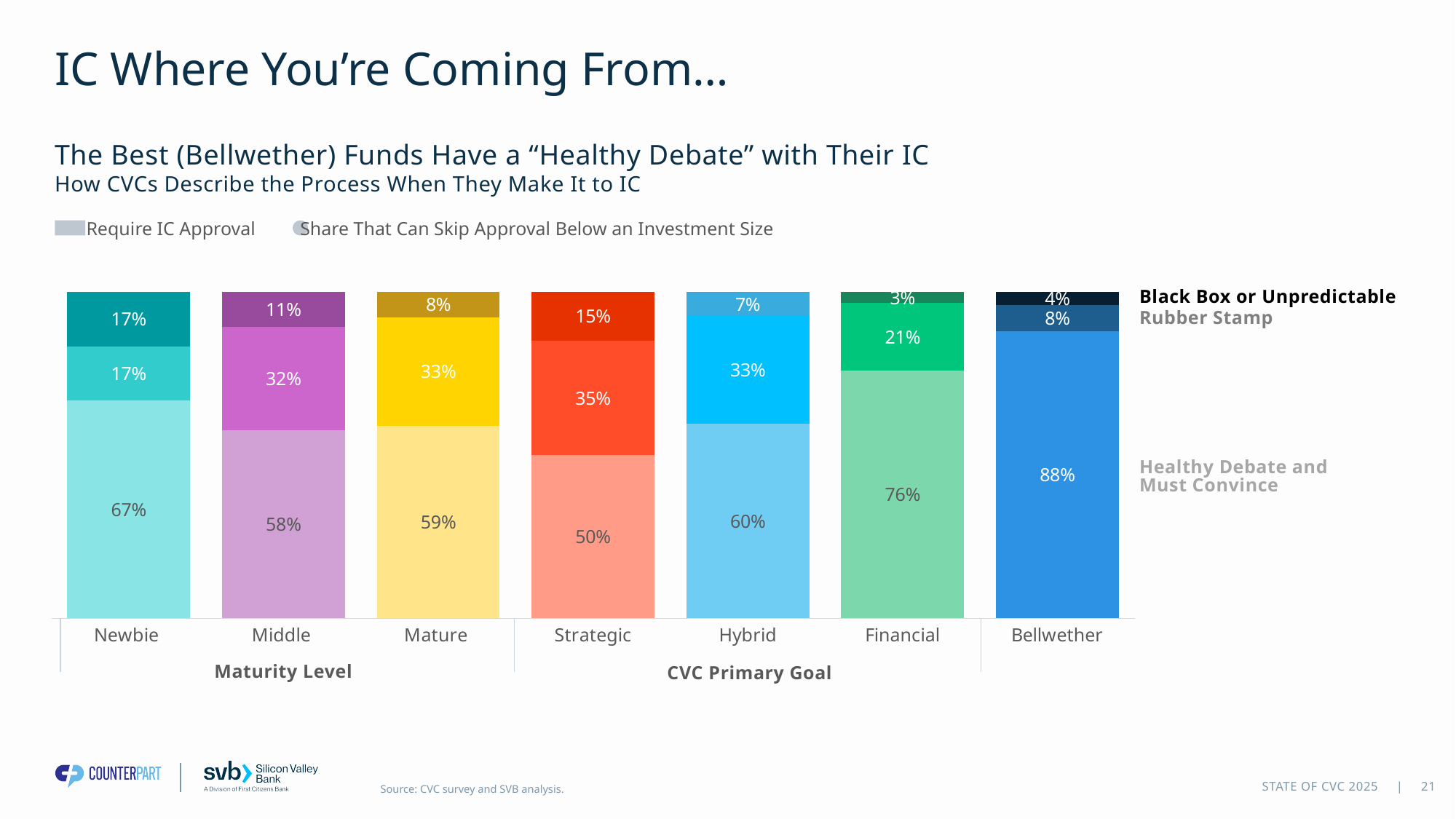
Which category has the highest Healthy Debate and Must Convince share? Bellwether Which category has the lowest Black Box or Unpredictable share? Financial What type of chart is used on this slide? Stacked bar chart Which category has the lowest Healthy Debate and Must Convince share? Strategic What is the Black Box or Unpredictable share for Newbie CVCs? 17% How many categories are shown along the x axis of the chart? 7 Which is larger, the Rubber Stamp share for Middle or for Mature CVCs? Mature Which two group headings are shown beneath the x-axis categories? Maturity Level and CVC Primary Goal What is the Rubber Stamp share for Strategic CVCs? 35% What is the total of the Hybrid bar's three segments? 100% What is the difference between the Healthy Debate and Must Convince shares for Financial and Strategic CVCs? 26% What percentage of Bellwether funds describe the IC process as Healthy Debate and Must Convince? 88%